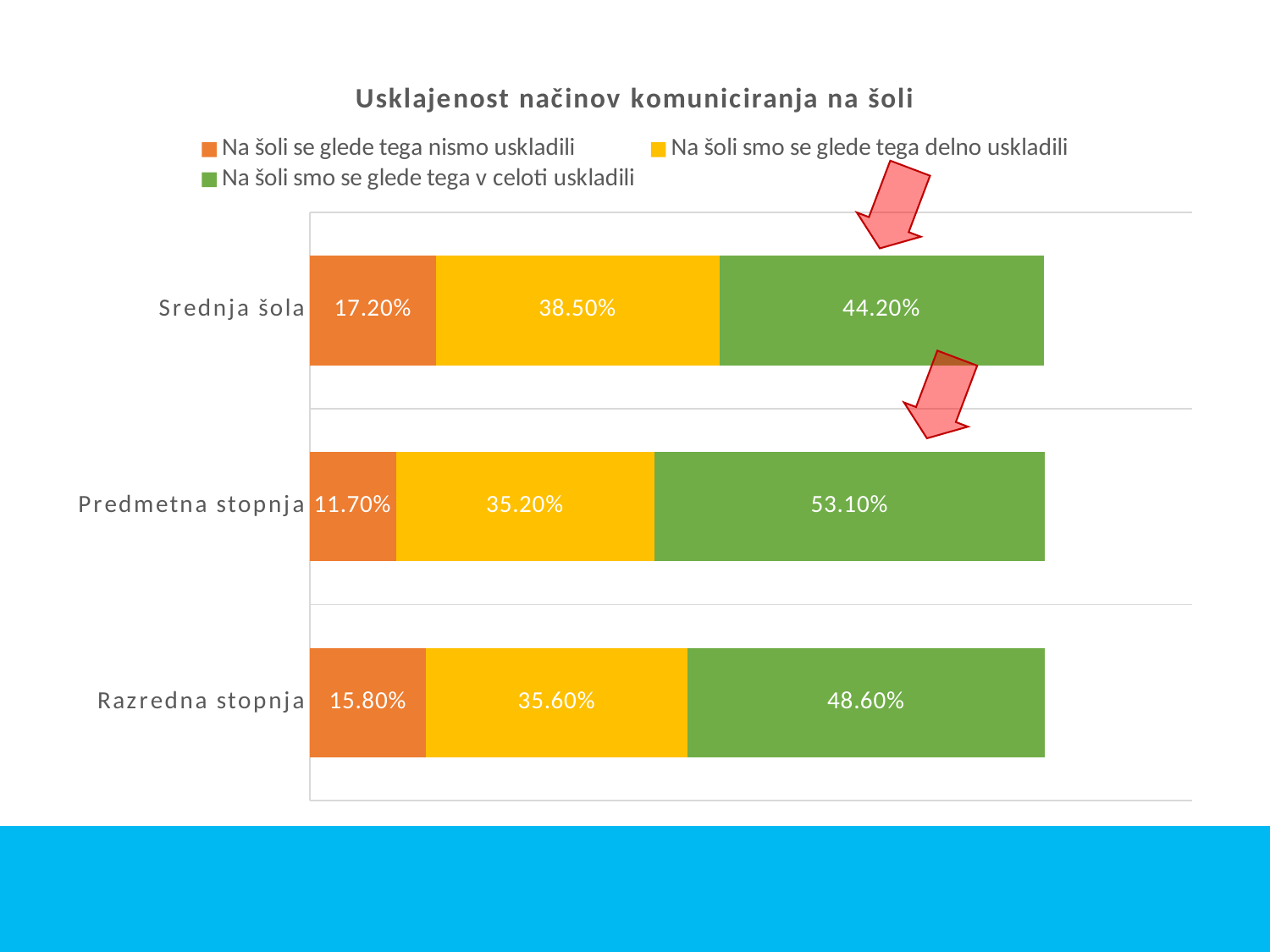
Which category has the lowest value for 'Na šoli se glede tega nismo uskladili'? Predmetna stopnja What is the title of the chart? Usklajenost načinov komuniciranja na šoli How many categories are shown on the chart? 3 Which category has the highest value for 'Na šoli smo se glede tega v celoti uskladili'? Predmetna stopnja Which is larger: the 'Na šoli smo se glede tega delno uskladili' value for Srednja šola or for Razredna stopnja? Srednja šola How many series does the legend list? 3 What is the value of 'Na šoli se glede tega nismo uskladili' for Srednja šola? 17.20% What is the total of the stacked bar for Razredna stopnja? 100.00% What kind of chart is shown on the slide? Stacked bar chart What is the value of 'Na šoli smo se glede tega v celoti uskladili' for Predmetna stopnja? 53.10% What is the value of 'Na šoli smo se glede tega delno uskladili' for Razredna stopnja? 35.60% What is the difference between the 'Na šoli smo se glede tega v celoti uskladili' values for Predmetna stopnja and Srednja šola? 8.90%